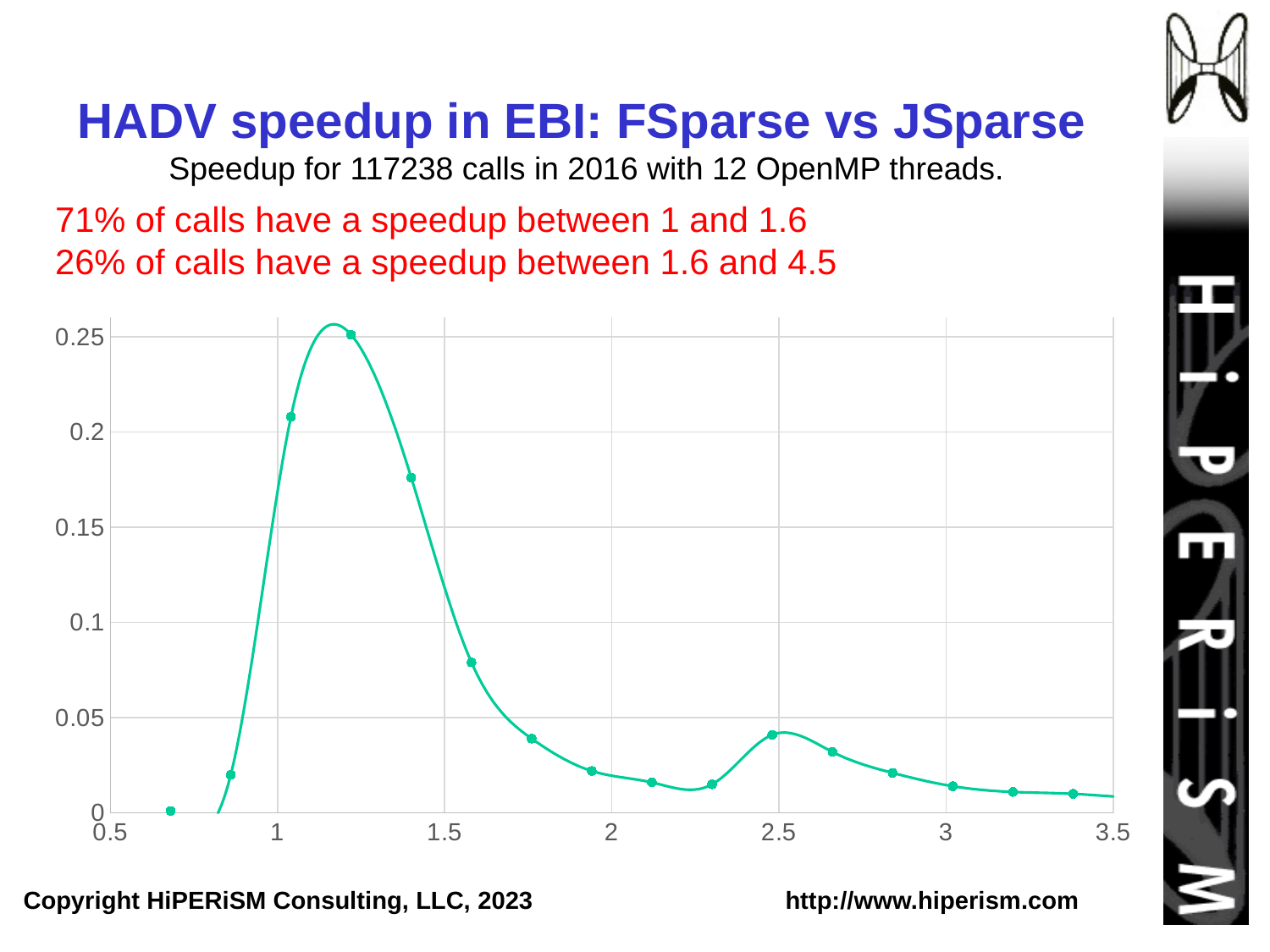
Do the values rise or fall along the x axis between speedups of 1.2 and 2.1? fall What is the largest value shown on the x axis? 3.5 What kind of chart is shown on the slide? line chart What is the title of the slide's chart? HADV speedup in EBI: FSparse vs JSparse Which is larger: the value of the curve near a speedup of 1.2 or near a speedup of 2.5? near 1.2 Is the value of the curve at a speedup of 1.5 greater or less than 0.15? less Is the peak value of the curve greater or less than 0.2? greater Do the values rise or fall along the x axis between speedups of 0.9 and 1.2? rise Is the value of the curve at a speedup of 3.0 greater or less than 0.05? less How many data points are plotted on the curve? 16